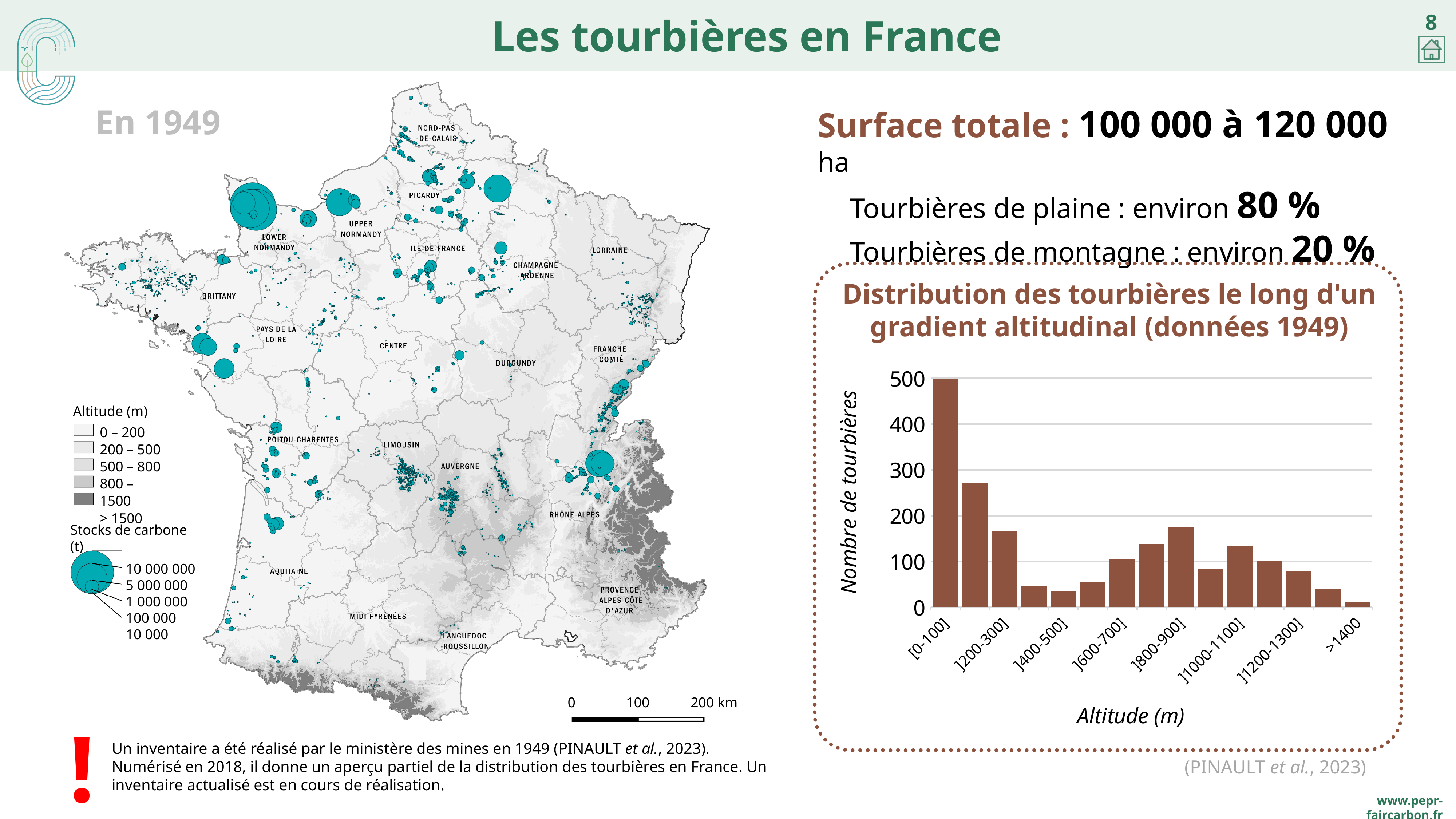
In the bar chart, which altitude class has the lowest number of tourbières? >1400 In the bar chart, is the value for ]200-300] greater or less than 200? less In the bar chart, is the value for [0-100] greater or less than 400? greater In the bar chart, is the value for ]800-900] greater or less than 100? greater In the bar chart, do the values rise or fall from [0-100] to ]400-500]? fall In the bar chart, which is larger: the value for ]800-900] or the value for ]1200-1300]? ]800-900] How many bars are plotted in the bar chart? 15 In the bar chart, which is larger: the value for ]200-300] or the value for ]400-500]? ]200-300] What is the label of the y axis of the bar chart? Nombre de tourbières What kind of chart is 'Distribution des tourbières le long d'un gradient altitudinal (données 1949)'? bar chart In the bar chart, which altitude class has the highest number of tourbières? [0-100]